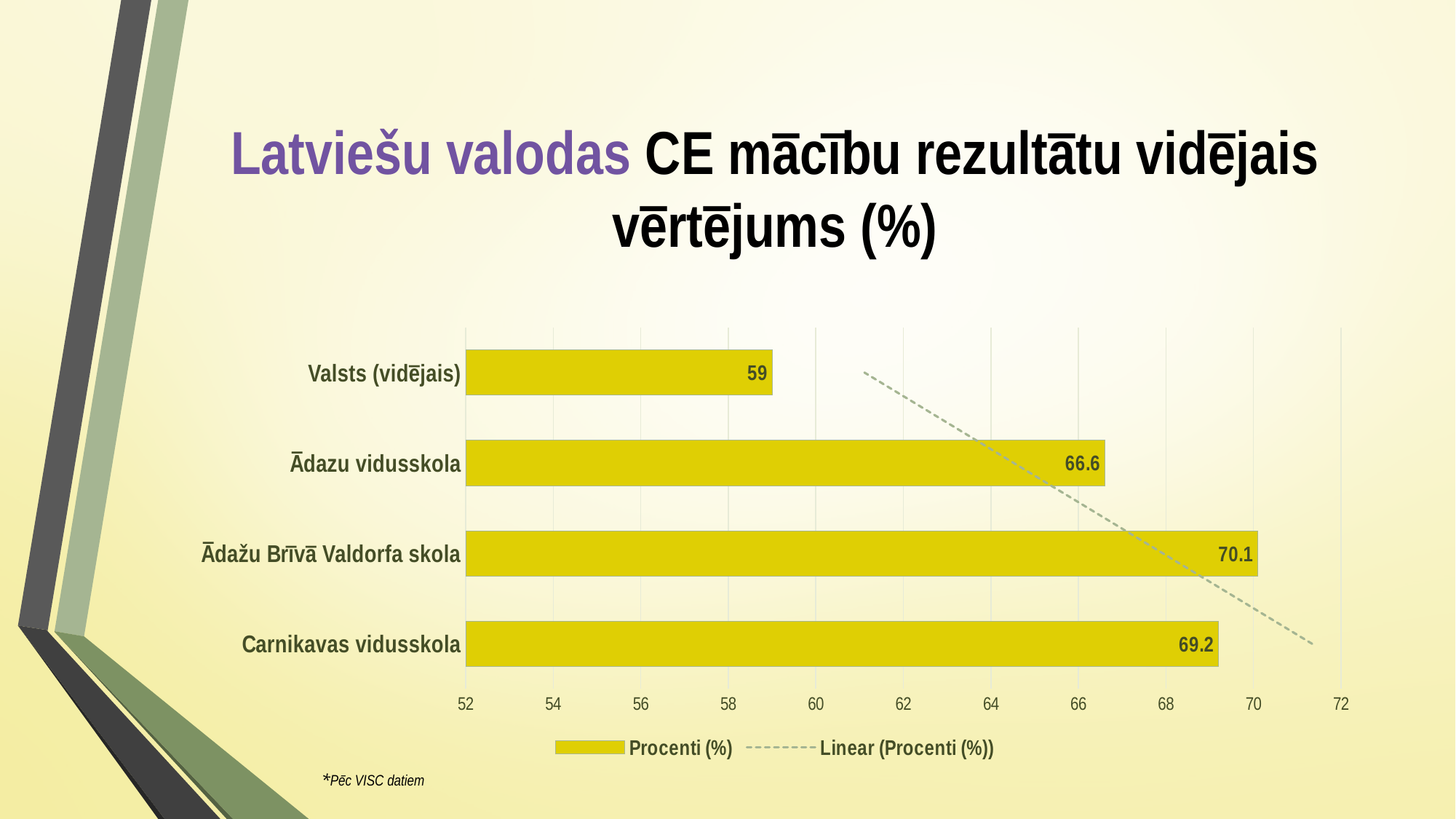
Which is larger, the value for Ādazu vidusskola or the value for Carnikavas vidusskola? Carnikavas vidusskola What is the value for Valsts (vidējais)? 59 What is the difference between the values for Carnikavas vidusskola and Ādazu vidusskola? 2.6 Which category has the highest value? Ādažu Brīvā Valdorfa skola What is the difference between the values for Ādažu Brīvā Valdorfa skola and Valsts (vidējais)? 11.1 What is the value for Carnikavas vidusskola? 69.2 What kind of chart is shown on the slide? bar chart Which category has the lowest value? Valsts (vidējais) What is the value for Ādažu Brīvā Valdorfa skola? 70.1 Is the value for Ādazu vidusskola greater or less than 64? greater How many categories are shown in the chart? 4 How many entries does the legend list? 2